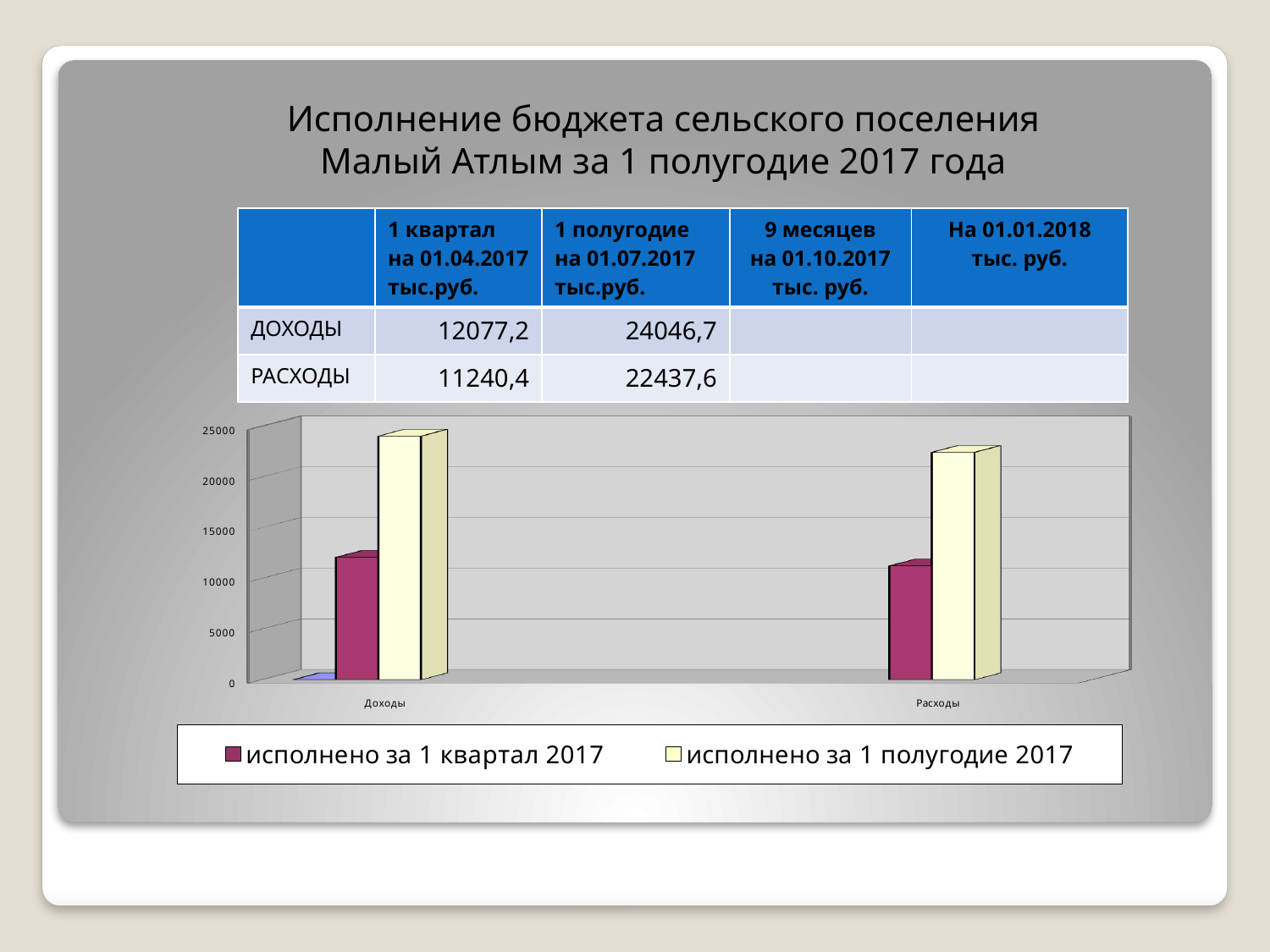
How many categories are shown on the x axis of the chart? 2 According to the table above the chart, what is the difference between ДОХОДЫ and РАСХОДЫ for 1 полугодие на 01.07.2017? 1609,1 What are the two legend entries of the chart? исполнено за 1 квартал 2017; исполнено за 1 полугодие 2017 Is the value for Расходы in the series 'исполнено за 1 квартал 2017' greater or less than 15000? less According to the table above the chart, what is the value of ДОХОДЫ for 1 полугодие на 01.07.2017? 24046,7 How many series does the chart legend list? 2 For Доходы, which series has the larger value, 'исполнено за 1 квартал 2017' or 'исполнено за 1 полугодие 2017'? исполнено за 1 полугодие 2017 Is the value for Расходы in the series 'исполнено за 1 полугодие 2017' greater or less than 20000? greater Is the value for Доходы in the series 'исполнено за 1 полугодие 2017' greater or less than 20000? greater Which category has the tallest bar in the chart? Доходы What kind of chart is shown on the slide? bar chart In the series 'исполнено за 1 полугодие 2017', which category has the larger value, Доходы or Расходы? Доходы